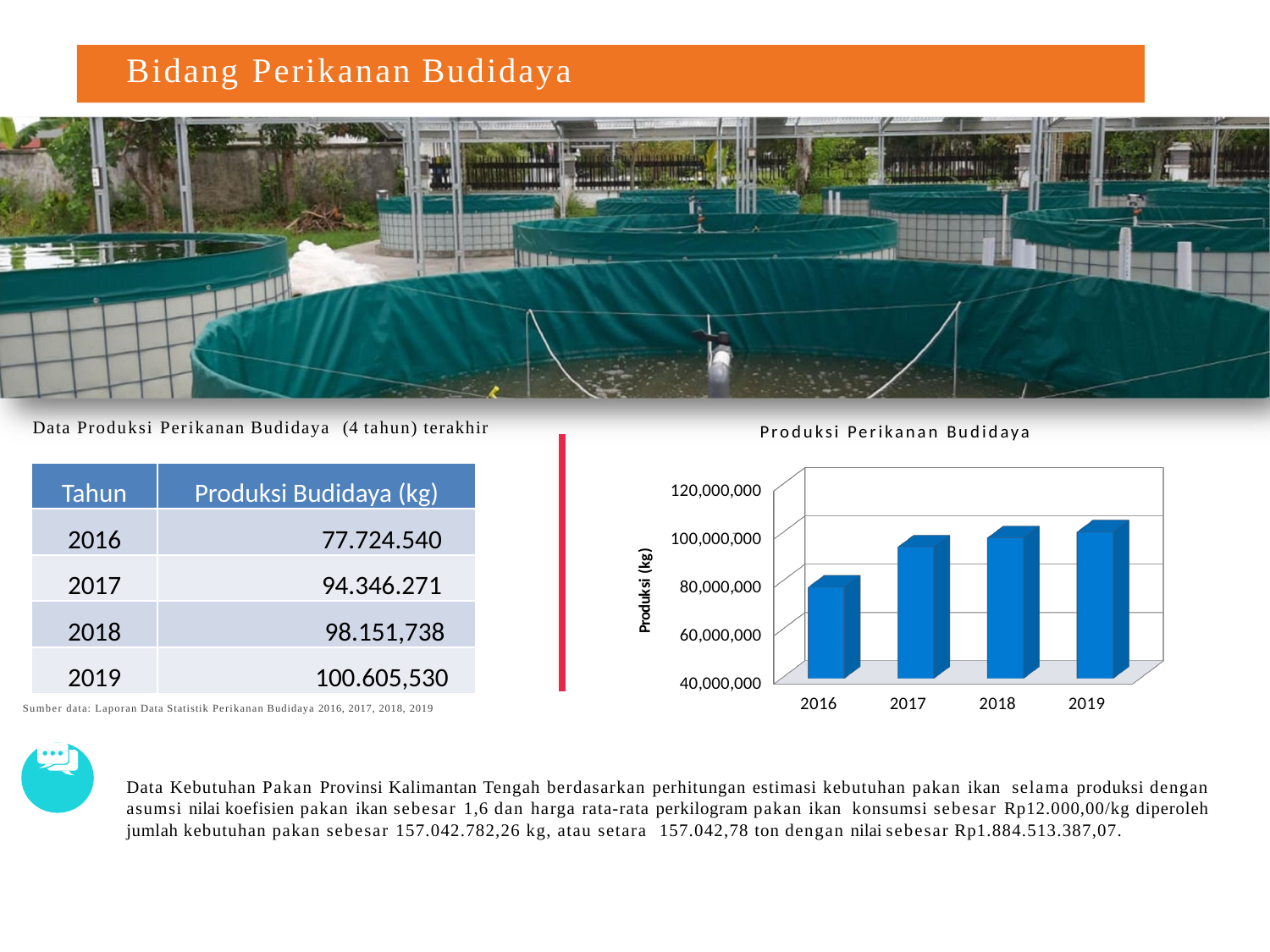
Is the value for 2016 on the 'Produksi Perikanan Budidaya' chart greater or less than 80,000,000? less What is the lowest tick value shown on the vertical axis of the 'Produksi Perikanan Budidaya' chart? 40,000,000 What type of chart is shown under the title 'Produksi Perikanan Budidaya'? bar chart Which year has the lowest bar on the 'Produksi Perikanan Budidaya' chart? 2016 On the 'Produksi Perikanan Budidaya' chart, which is larger, the value for 2016 or the value for 2019? 2019 On the 'Produksi Perikanan Budidaya' chart, which is larger, the value for 2016 or the value for 2017? 2017 What is the label on the vertical axis of the 'Produksi Perikanan Budidaya' chart? Produksi (kg) Do the values on the 'Produksi Perikanan Budidaya' chart rise or fall from 2016 to 2019? rise Is the value for 2017 on the 'Produksi Perikanan Budidaya' chart greater or less than 100,000,000? less How many years are plotted on the 'Produksi Perikanan Budidaya' chart? 4 Is the value for 2017 on the 'Produksi Perikanan Budidaya' chart greater or less than 80,000,000? greater